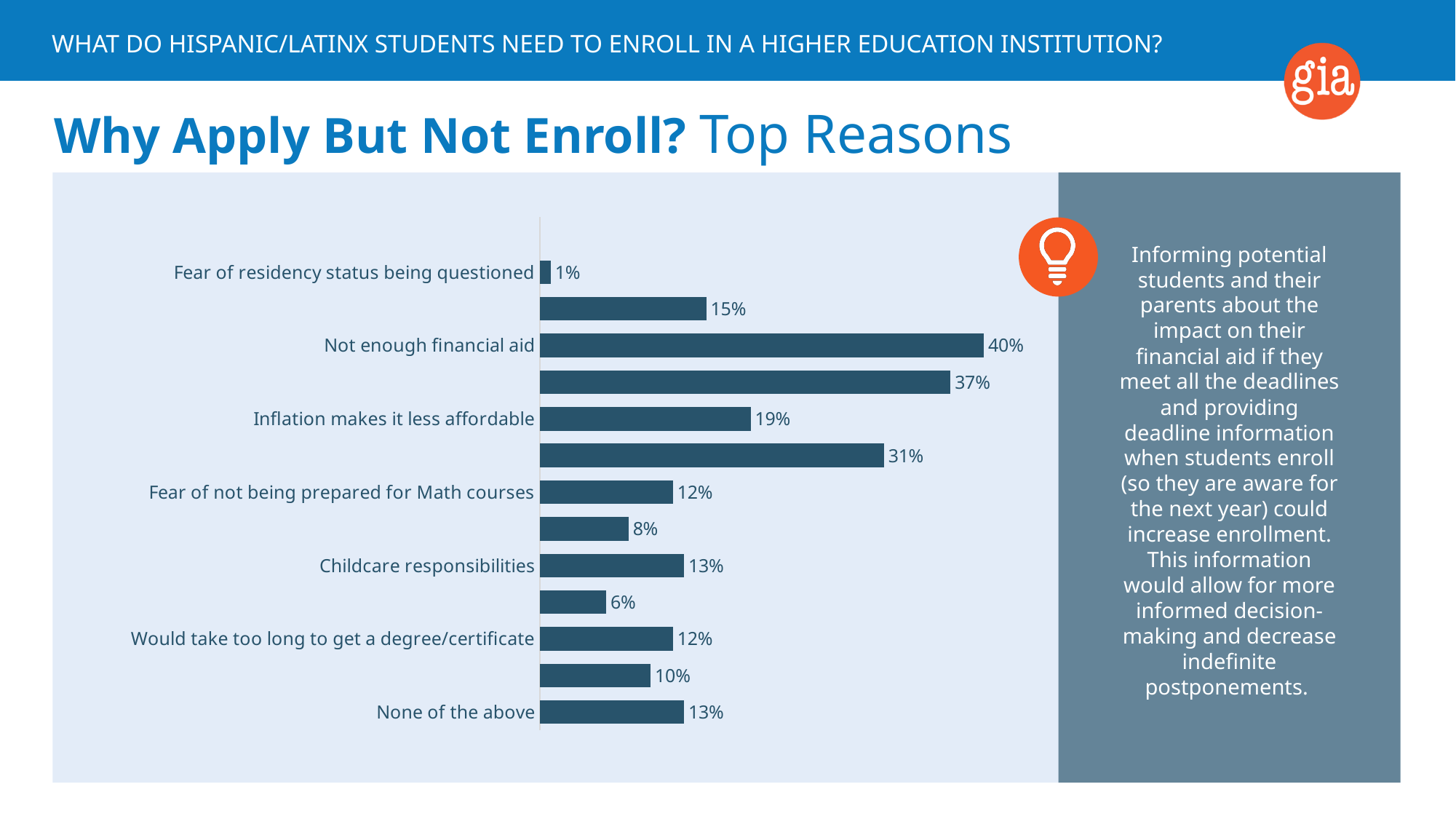
What percentage is shown for "Inflation makes it less affordable"? 19% What percentage is shown for "Would take too long to get a degree/certificate"? 12% What is the value for "None of the above"? 13% What type of chart is shown on the slide? Bar chart What is the value for "Childcare responsibilities"? 13% What is the title of the slide containing the chart? Why Apply But Not Enroll? Top Reasons What is the difference in percentage points between "Not enough financial aid" and "Inflation makes it less affordable"? 21 percentage points What percentage is shown for "Not enough financial aid"? 40% Which labeled reason has the lowest percentage? Fear of residency status being questioned Which labeled reason has the highest percentage? Not enough financial aid Which is larger: the value for "Inflation makes it less affordable" or for "Fear of not being prepared for Math courses"? Inflation makes it less affordable What is the value for "Fear of residency status being questioned"? 1%